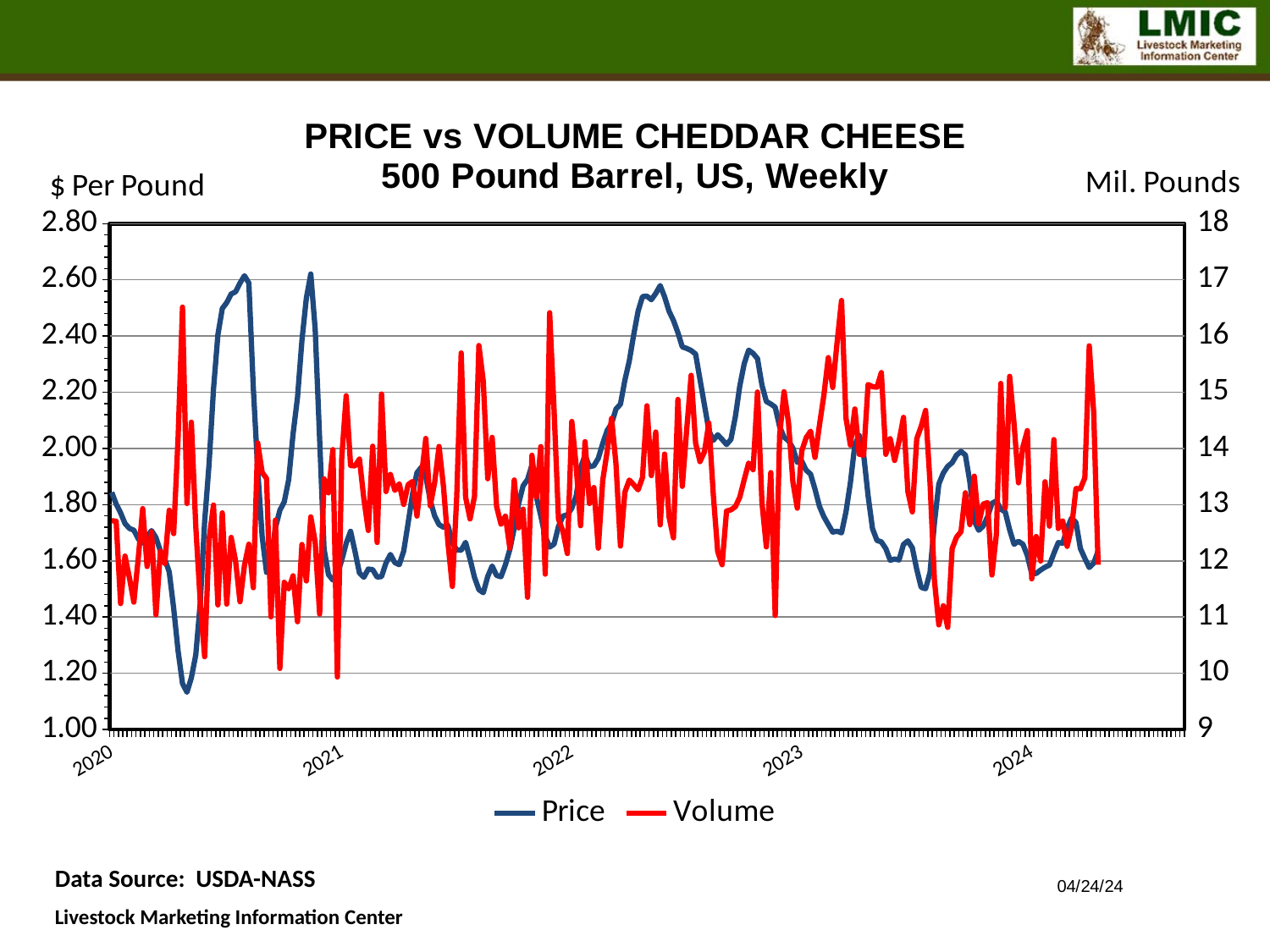
What is the title of the chart? PRICE vs VOLUME CHEDDAR CHEESE 500 Pound Barrel, US, Weekly Is the lowest Price value reached in 2020 greater or less than 1.20 $ per pound? less What kind of chart is shown on the slide? line chart Is the peak Price value in 2022 greater or less than 2.40 $ per pound? greater Does the Price series rise or fall from the start of 2022 to its mid-2022 peak? rise Is the Price value at the start of 2021 greater or less than 2.40 $ per pound? less Does the Price series rise or fall from its mid-2022 peak to the start of 2023? fall Which series is drawn in red? Volume How many series does the legend list? 2